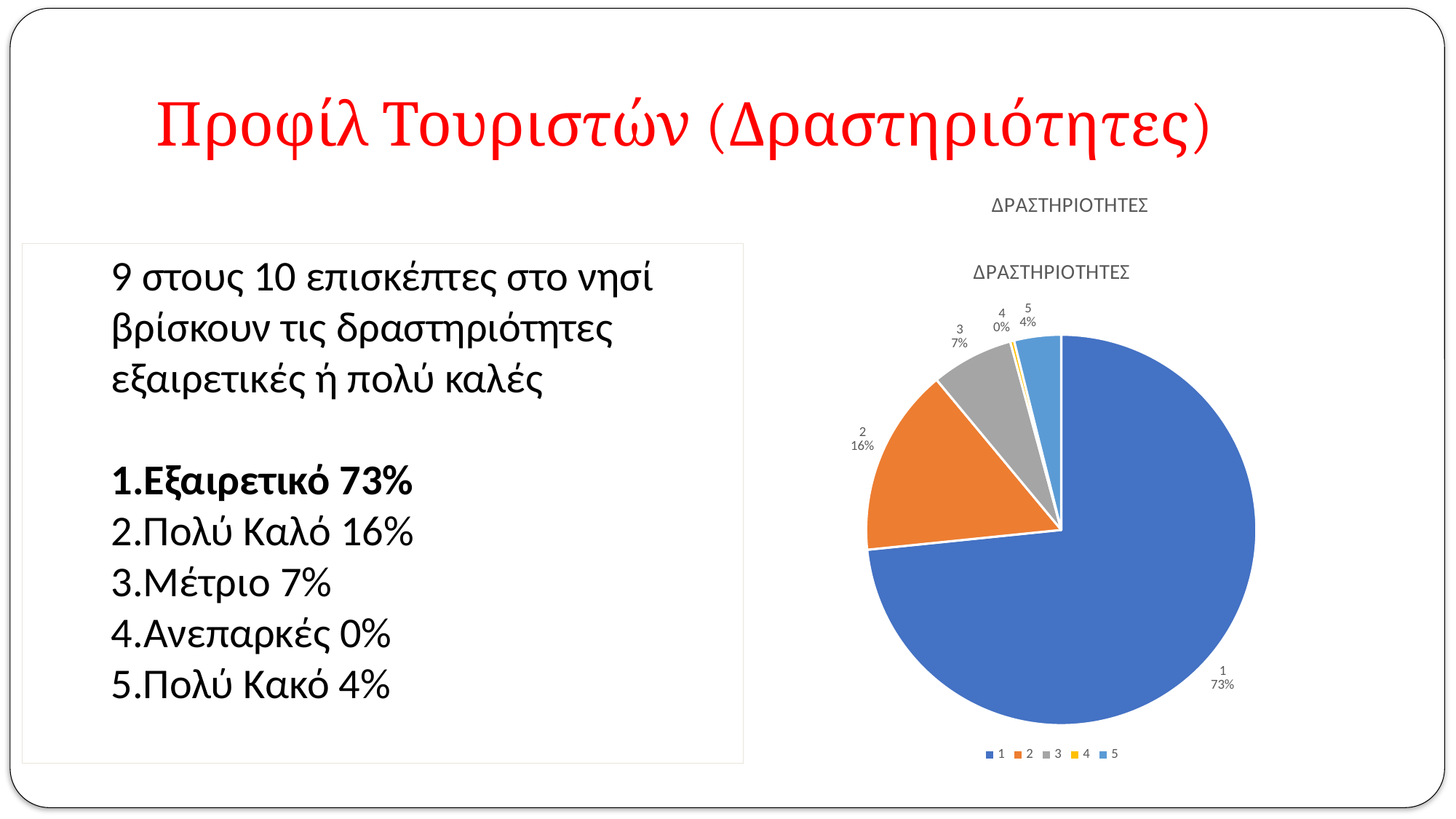
What percentage does slice 1 represent in the pie chart? 73% What percentage does slice 4 represent in the pie chart? 0% Which category has the largest slice in the pie chart? 1 What is the difference in percentage points between slice 1 and slice 2? 57 What is the title of the chart? ΔΡΑΣΤΗΡΙΟΤΗΤΕΣ What kind of chart is shown on the slide? pie chart What percentage does slice 3 represent in the pie chart? 7% How many entries does the legend list? 5 What percentage does slice 5 represent in the pie chart? 4% Which category has the smallest slice in the pie chart? 4 Which is larger, slice 3 or slice 5? 3 What percentage does slice 2 represent in the pie chart? 16%